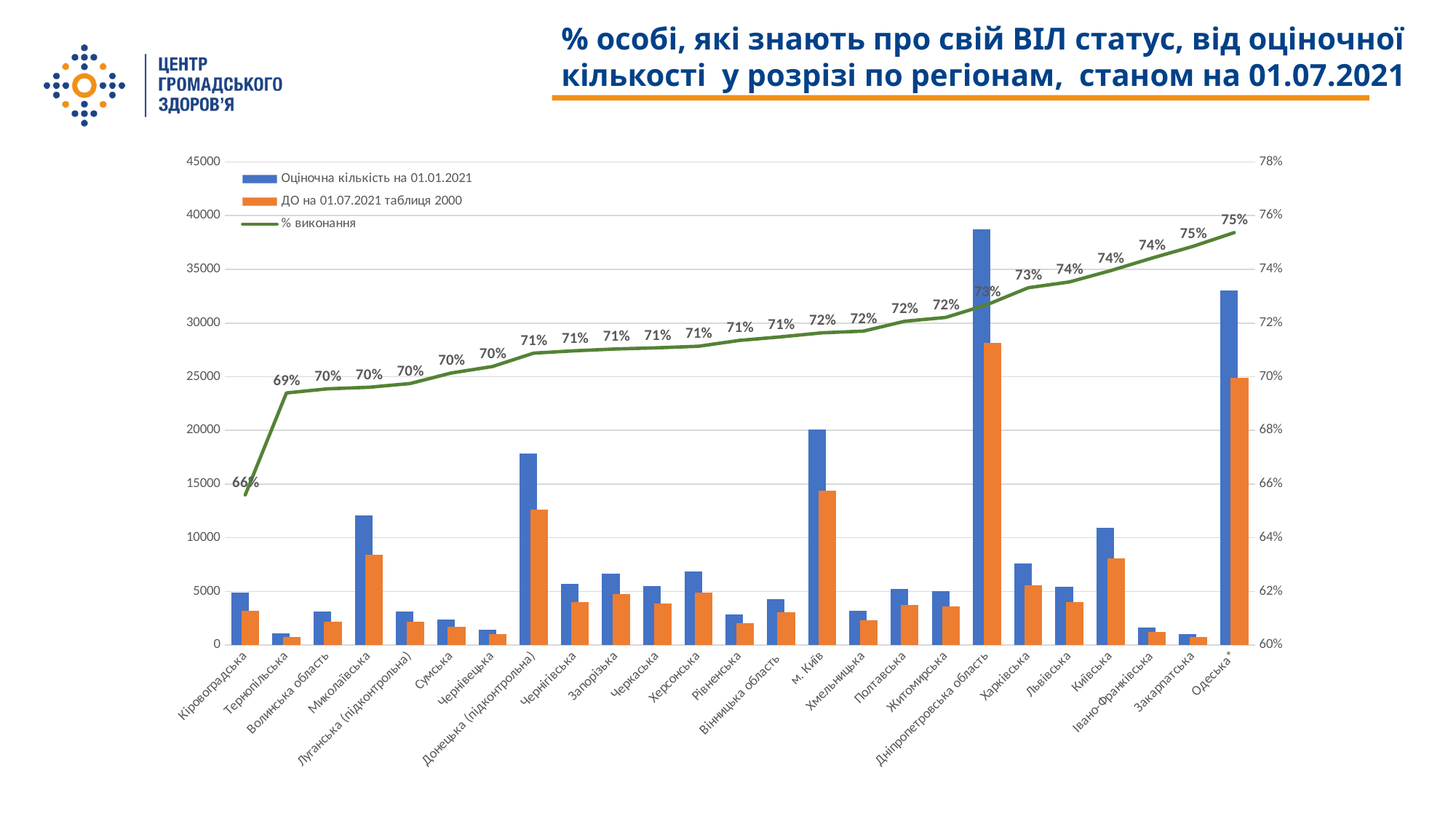
How many regions are shown on the x axis? 25 What is the % виконання value for Одеська *? 75% What is the difference in % виконання between Одеська * and Кіровоградська? 9 percentage points How many series does the legend list? 3 Is the Оціночна кількість на 01.01.2021 value for Дніпропетровська область greater or less than 35000? greater Does the % виконання line rise or fall from left to right across the regions? rises What is the % виконання value for Дніпропетровська область? 73% Which region has the lowest % виконання? Кіровоградська Which region has the highest Оціночна кількість на 01.01.2021 bar? Дніпропетровська область What is the % виконання value for м. Київ? 72% Which has the larger Оціночна кількість на 01.01.2021 bar: Миколаївська or Донецька (підконтрольна)? Донецька (підконтрольна) What is the % виконання value for Кіровоградська? 66%